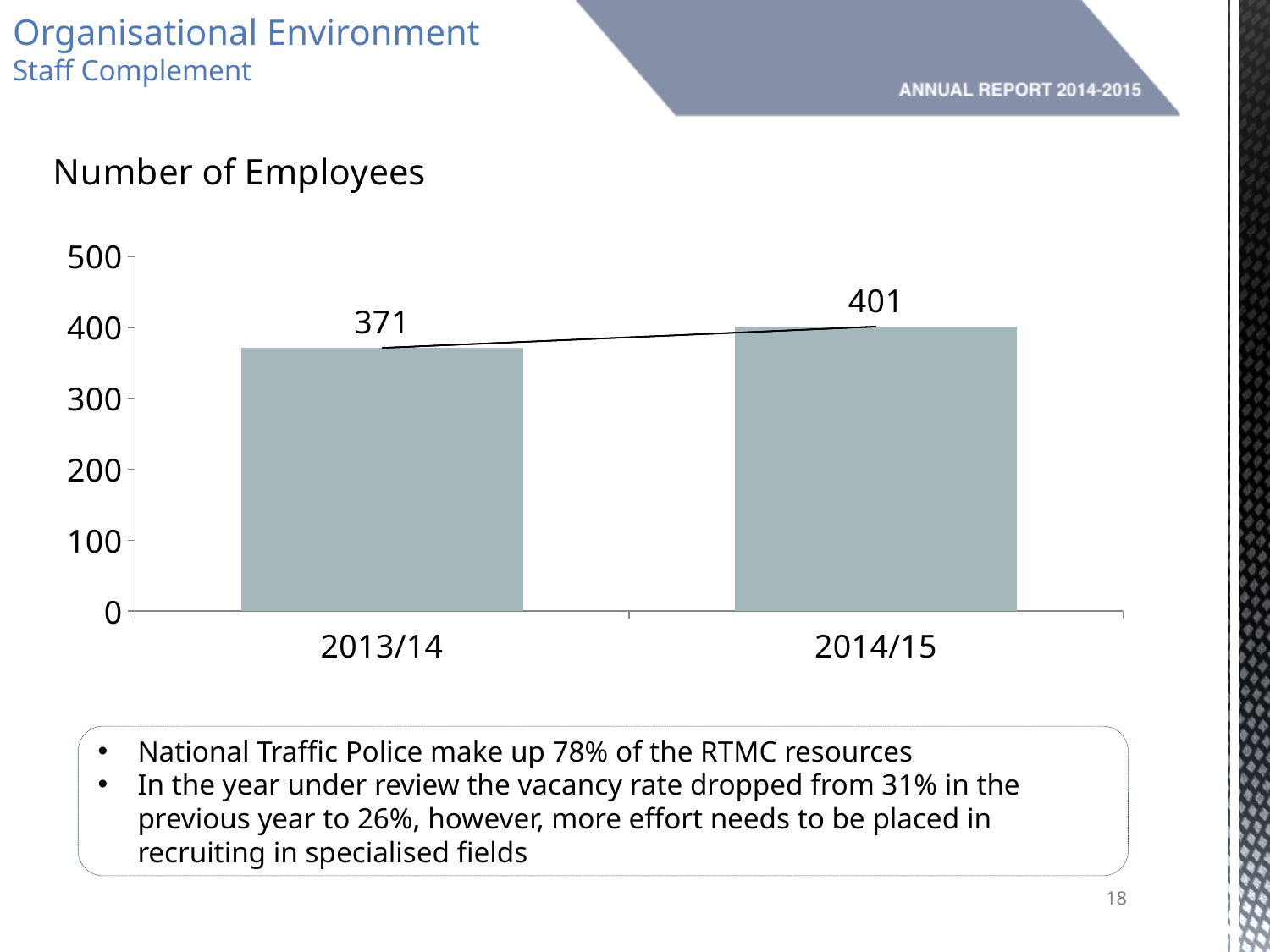
Is the value for 2014/15 greater or less than 400? greater What is the number of employees for 2013/14? 371 Is the number of employees larger in 2013/14 or 2014/15? 2014/15 What is the number of employees for 2014/15? 401 Does the number of employees rise or fall from 2013/14 to 2014/15? rise What is the difference in the number of employees between 2014/15 and 2013/14? 30 What is the title of the chart? Number of Employees Which year has the lower number of employees? 2013/14 Which year has the higher number of employees? 2014/15 What kind of chart is used to show the number of employees? bar chart Is the value for 2013/14 greater or less than 400? less How many years are shown on the x axis of the chart? 2